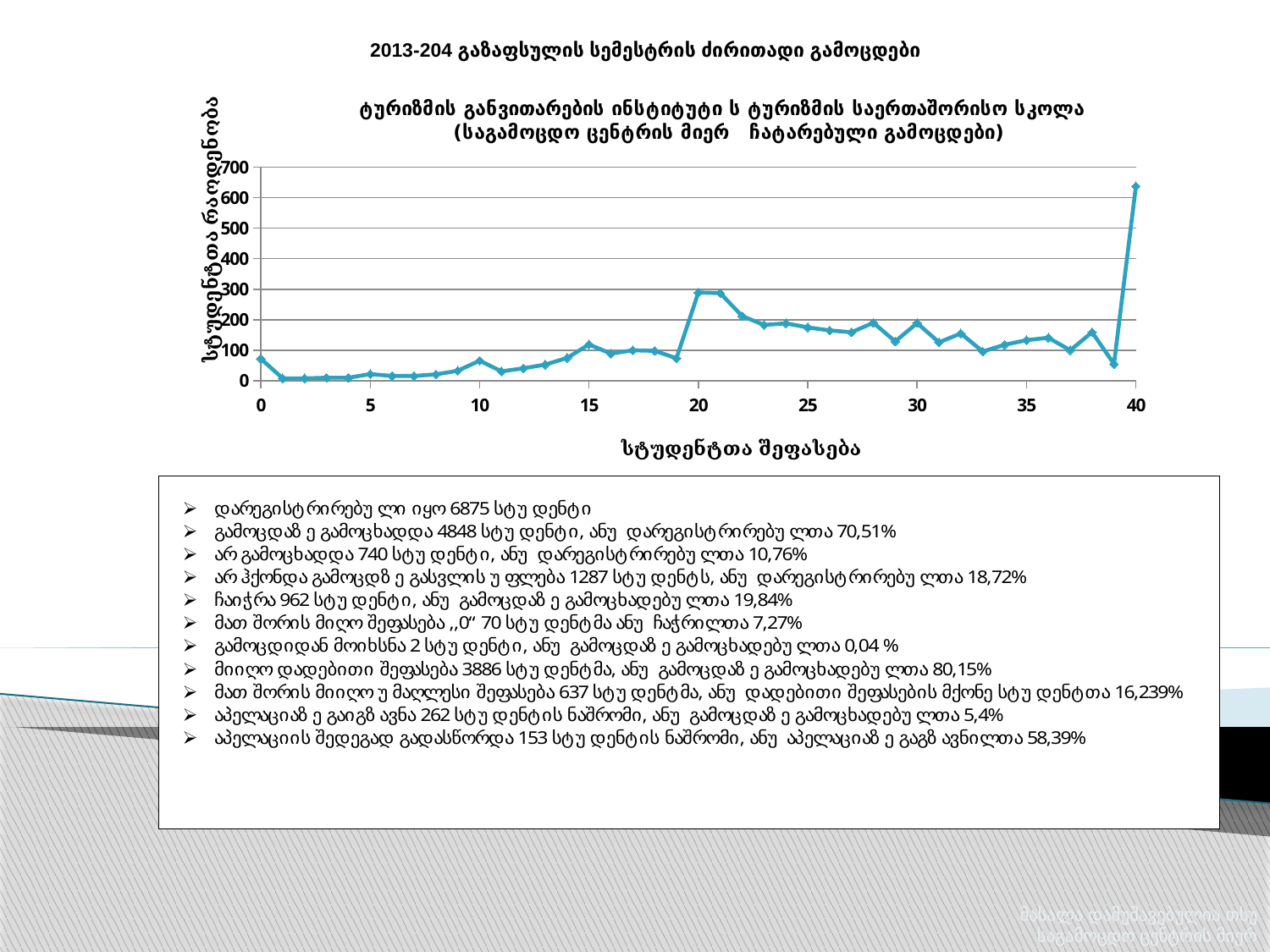
Is the value at x = 39 greater or less than 100? less What is the label of the y axis? სტუდენტთა რაოდენობა Is the value at x = 20 greater or less than 200? greater Is the value at x = 10 greater or less than 100? less Does the line rise or fall between x = 20 and x = 25? fall What kind of chart is shown on the slide? line chart Which is larger, the value at x = 20 or the value at x = 10? x = 20 At which x-axis value does the line reach its highest point? 40 What is the label of the x axis? სტუდენტთა შეფასება